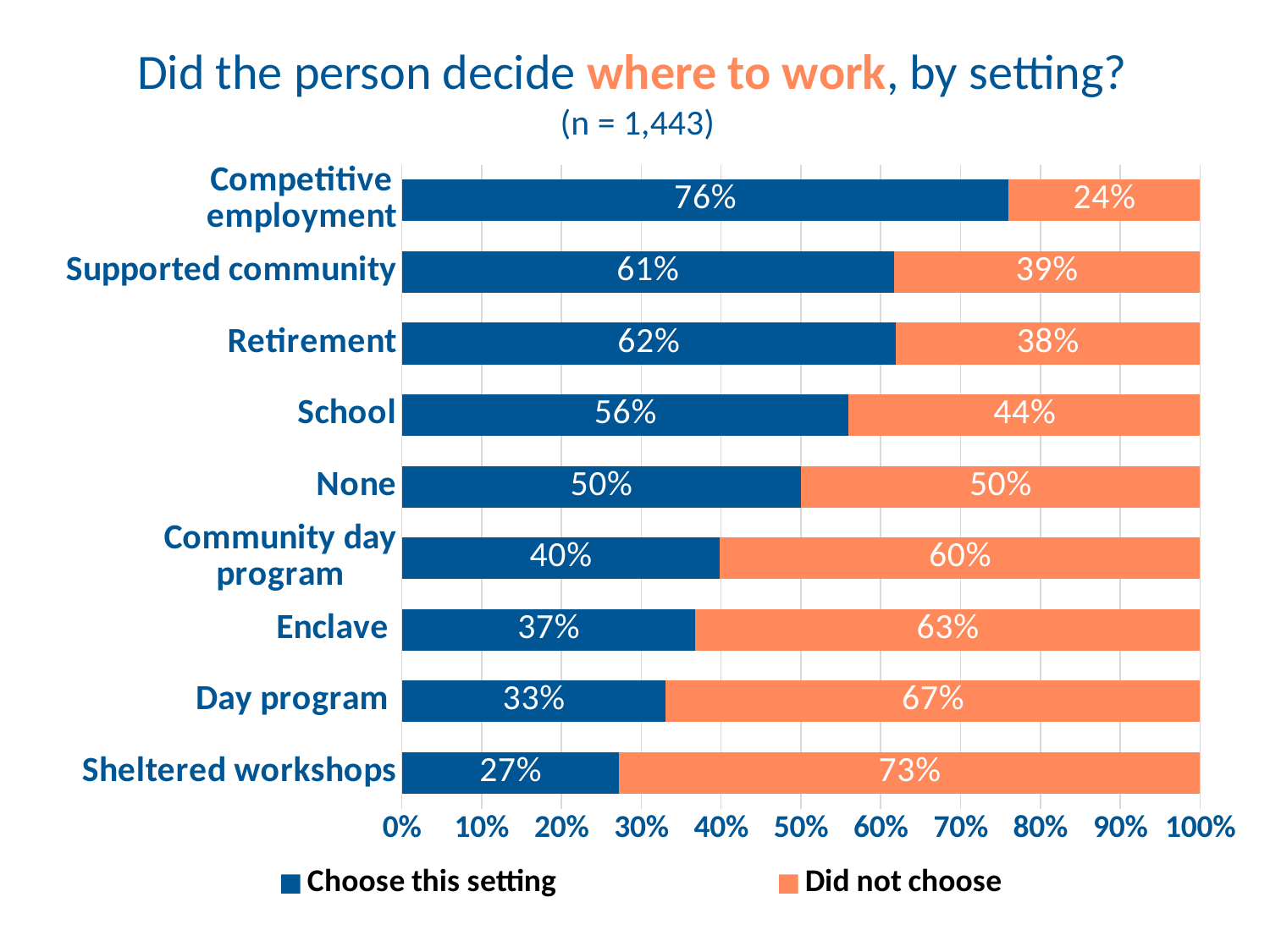
How many settings (categories) are shown in the chart? 9 What is the total of the stacked bar for None? 100% Which setting has the highest 'Choose this setting' percentage? Competitive employment What percentage of people in Competitive employment chose this setting? 76% What kind of chart is shown on the slide? Stacked bar chart What is the 'Did not choose' value for Sheltered workshops? 73% What is the difference between the 'Choose this setting' values for Competitive employment and Day program? 43% What is the sample size (n) shown under the chart title? 1,443 Which setting has the lowest 'Choose this setting' percentage? Sheltered workshops How many series does the legend list? 2 Which has a larger 'Choose this setting' value, School or Community day program? School What is the 'Choose this setting' value for Enclave? 37%